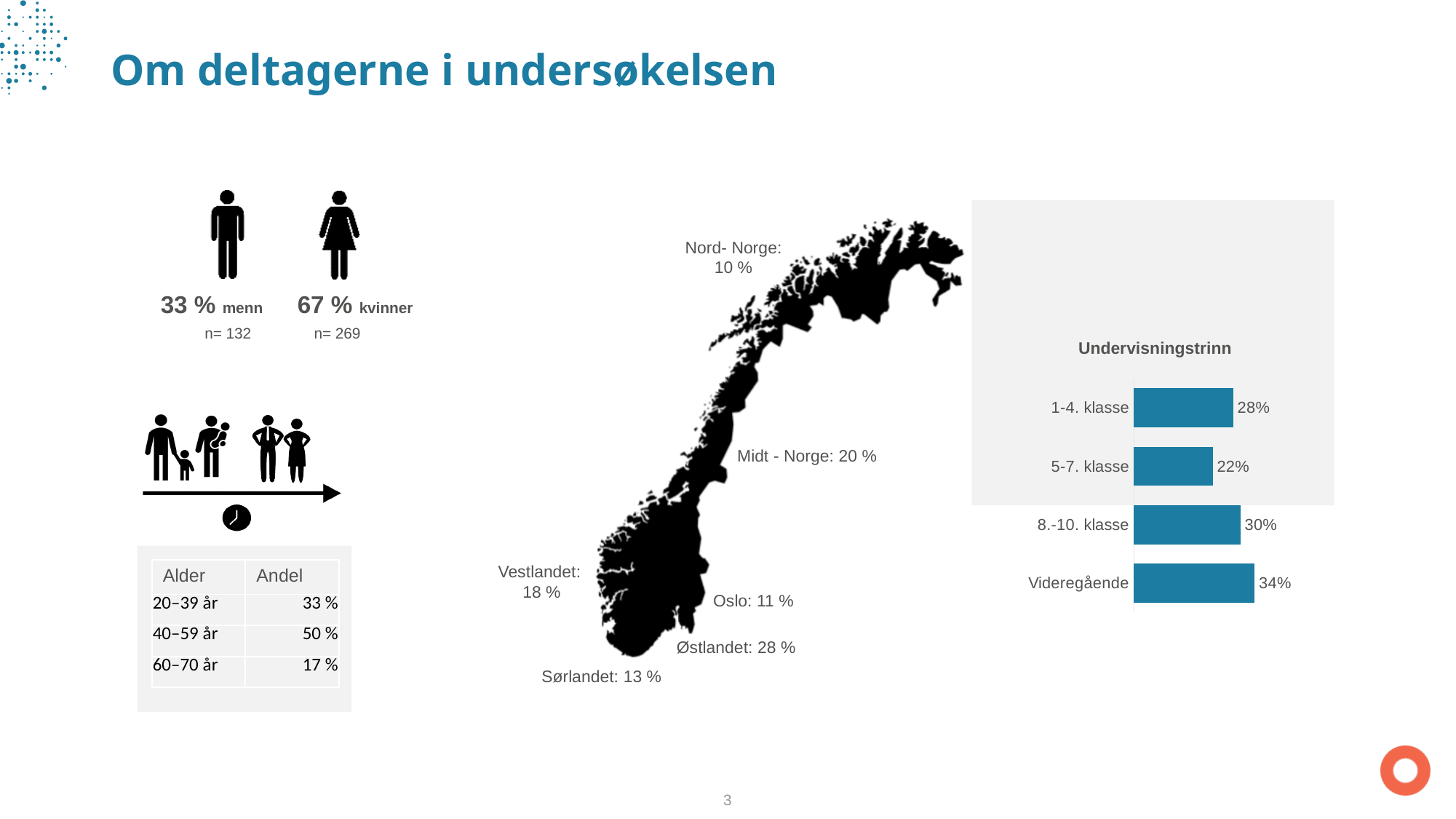
In the 'Undervisningstrinn' chart, what is the value for 8.-10. klasse? 30% In the 'Undervisningstrinn' chart, what is the value for 5-7. klasse? 22% In the 'Undervisningstrinn' chart, which category has the lowest value? 5-7. klasse In the 'Undervisningstrinn' chart, which is larger: 1-4. klasse or 8.-10. klasse? 8.-10. klasse In the 'Undervisningstrinn' chart, what is the difference between 8.-10. klasse and 1-4. klasse? 2% How many categories does the 'Undervisningstrinn' chart show? 4 What is the title of the bar chart on the right of the slide? Undervisningstrinn In the 'Undervisningstrinn' chart, what is the value for Videregående? 34% What kind of chart is the 'Undervisningstrinn' chart? Bar chart In the 'Undervisningstrinn' chart, what is the value for 1-4. klasse? 28% In the 'Undervisningstrinn' chart, which category has the highest value? Videregående In the 'Undervisningstrinn' chart, what is the difference between Videregående and 5-7. klasse? 12%